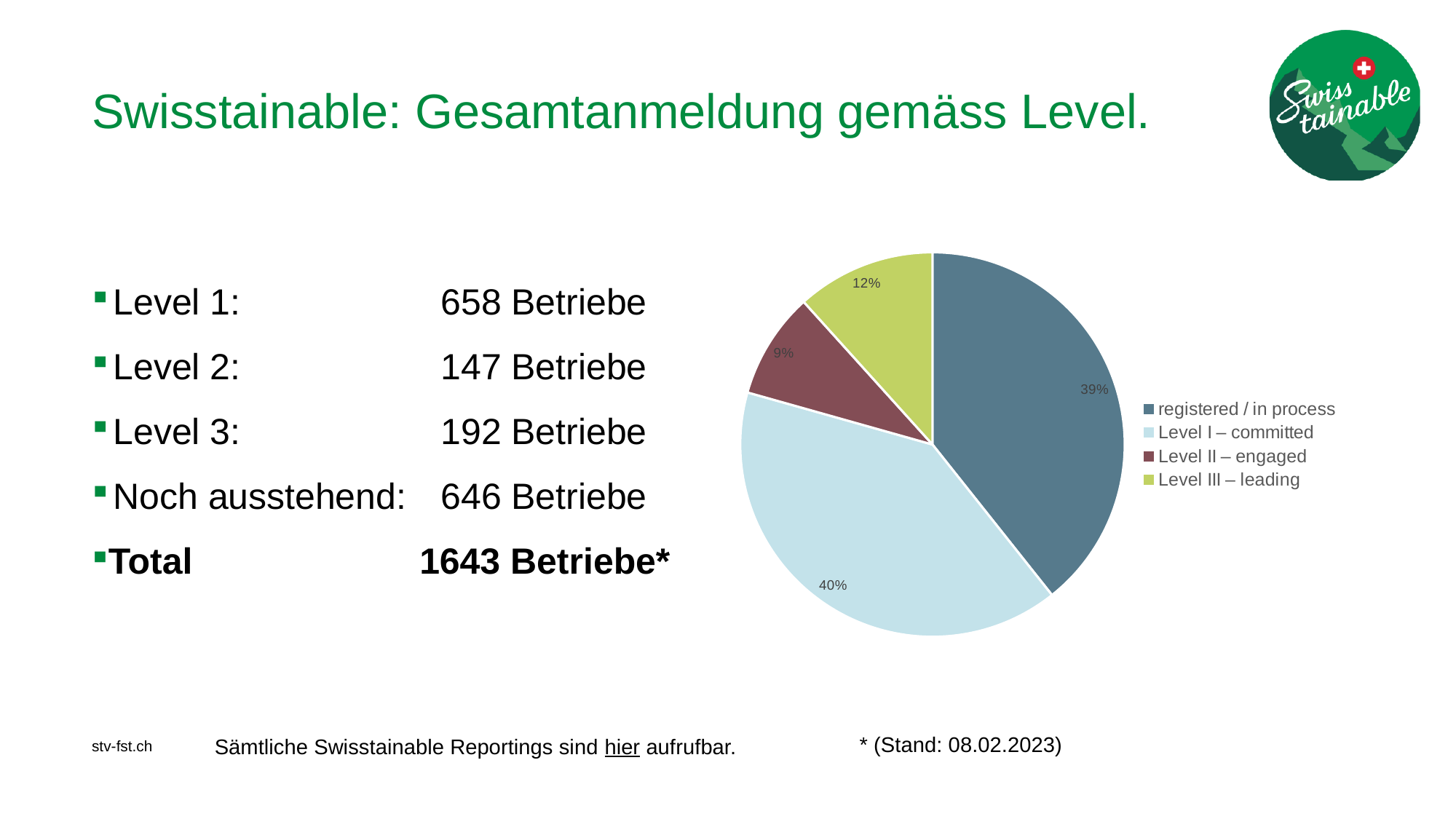
Which slice of the pie chart is the largest? Level I – committed How many slices does the pie chart have? 4 What type of chart is shown on the slide? Pie chart Which is larger in the pie chart: 'Level III – leading' or 'Level II – engaged'? Level III – leading What share of the pie chart does 'Level I – committed' represent? 40% What percentage of the pie chart is labelled for the 'registered / in process' slice? 39% What is the difference in percentage points between the 'Level I – committed' and 'registered / in process' slices? 1 percentage point How many entries does the legend of the pie chart list? 4 What is the difference in percentage points between the 'Level III – leading' and 'Level II – engaged' slices? 3 percentage points What share of the pie does 'Level III – leading' account for? 12% Which slice of the pie chart is the smallest? Level II – engaged What percentage is shown for the 'Level II – engaged' slice? 9%